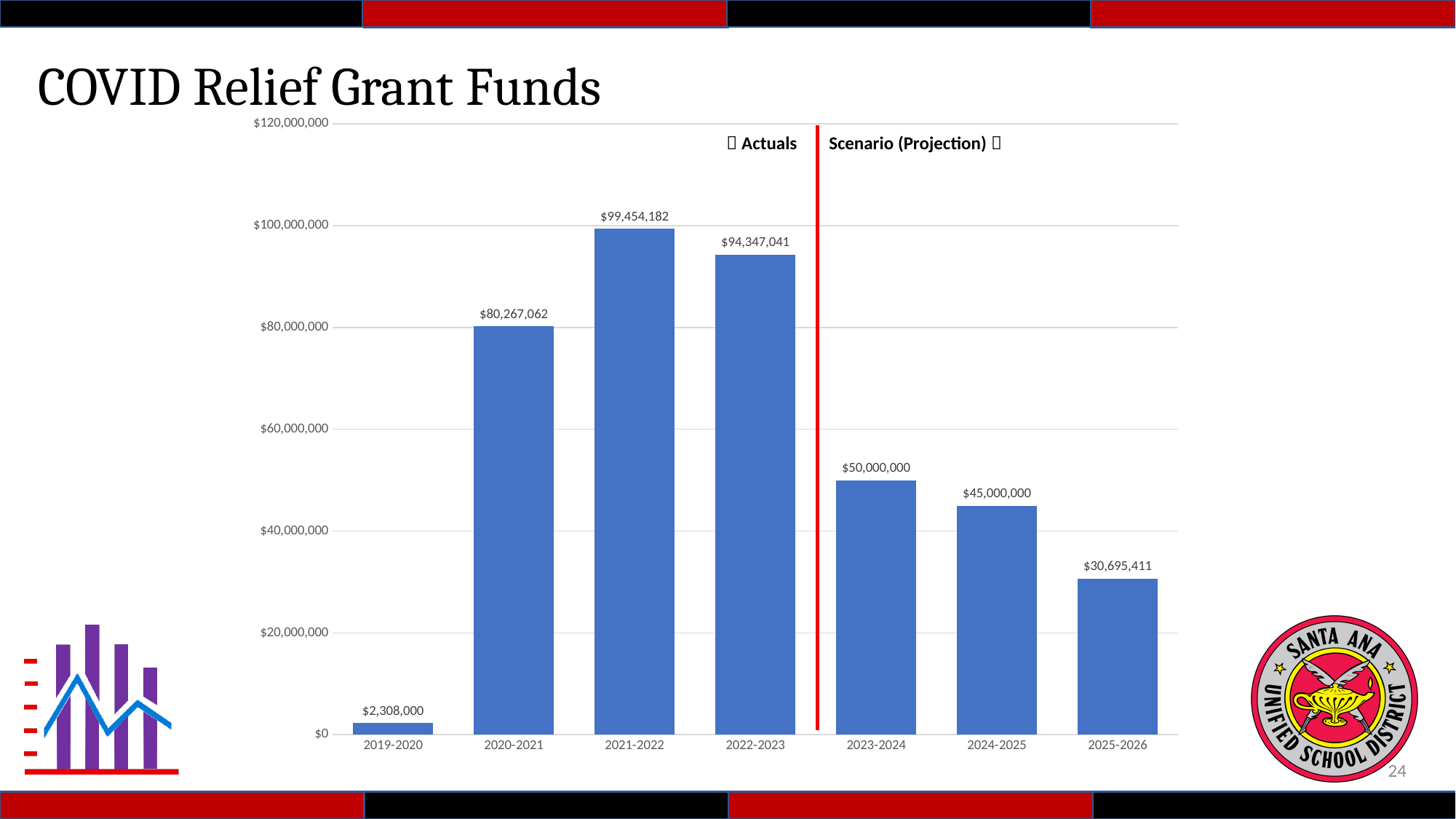
What is the value for 2025-2026? $30,695,411 Do the values rise or fall from 2021-2022 to 2025-2026? fall Which year has the lowest value? 2019-2020 What is the difference between the values for 2023-2024 and 2024-2025? $5,000,000 What is the difference between the values for 2021-2022 and 2022-2023? $5,107,141 Which year has the highest value? 2021-2022 What is the value for 2019-2020? $2,308,000 What is the value for 2021-2022? $99,454,182 How many years are shown on the x axis? 7 Is the value for 2024-2025 greater or less than $60,000,000? less What kind of chart is shown on the slide? bar chart Which is larger, the value for 2020-2021 or the value for 2022-2023? 2022-2023